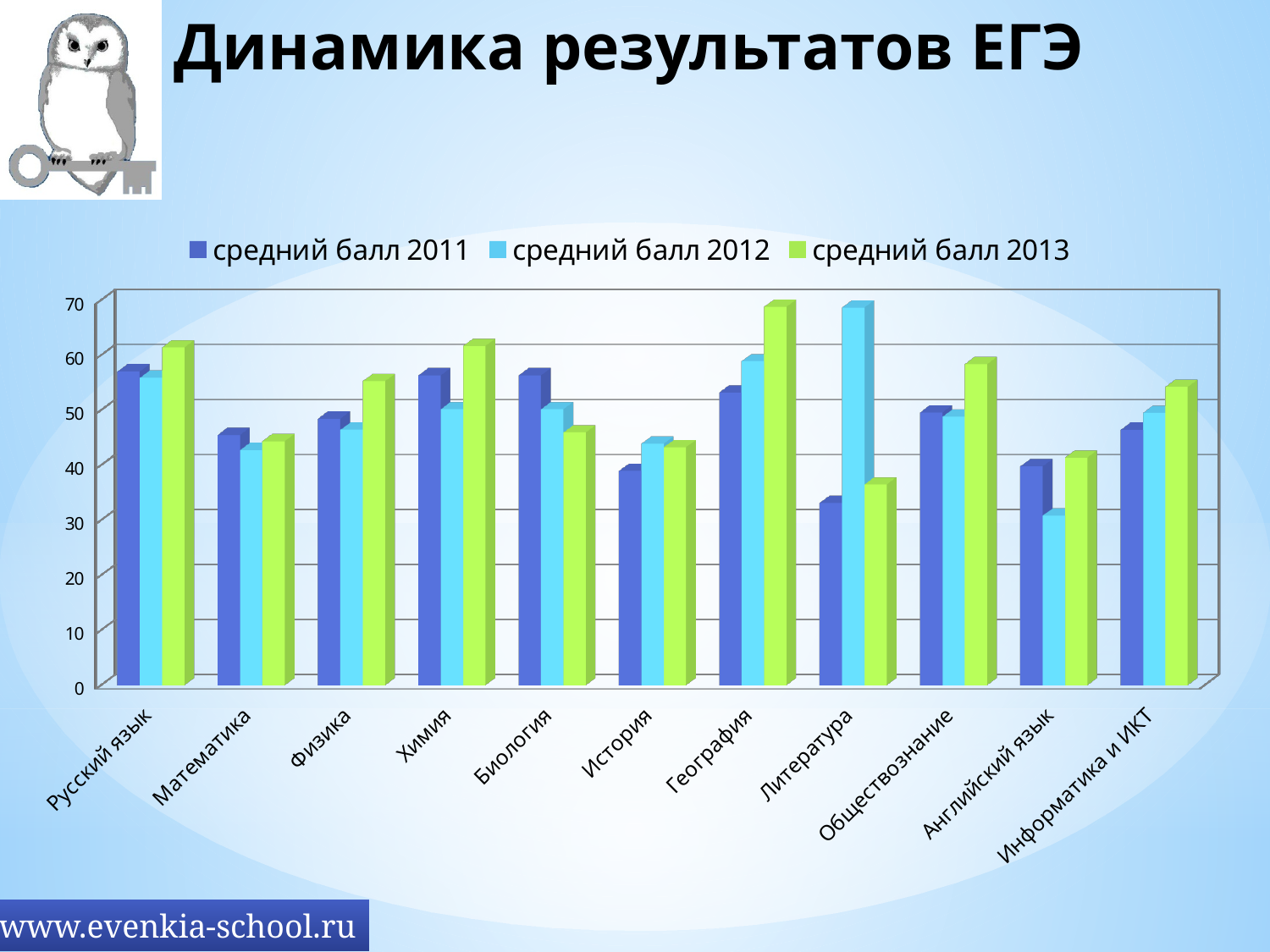
Is the value for География in the series средний балл 2013 greater or less than 60? greater Is the value for Литература in the series средний балл 2011 greater or less than 40? less For Биология, which is larger: средний балл 2011 or средний балл 2013? средний балл 2011 Is the value for Литература in the series средний балл 2012 greater or less than 60? greater How many subjects (categories) are shown on the x axis? 11 How many series does the legend list? 3 Which series is shown in green in the legend? средний балл 2013 What is the title of the slide with the chart? Динамика результатов ЕГЭ For Литература, which is larger: средний балл 2011 or средний балл 2012? средний балл 2012 What kind of chart is shown on the slide? bar chart Which subject has the lowest value in the series средний балл 2012? Английский язык